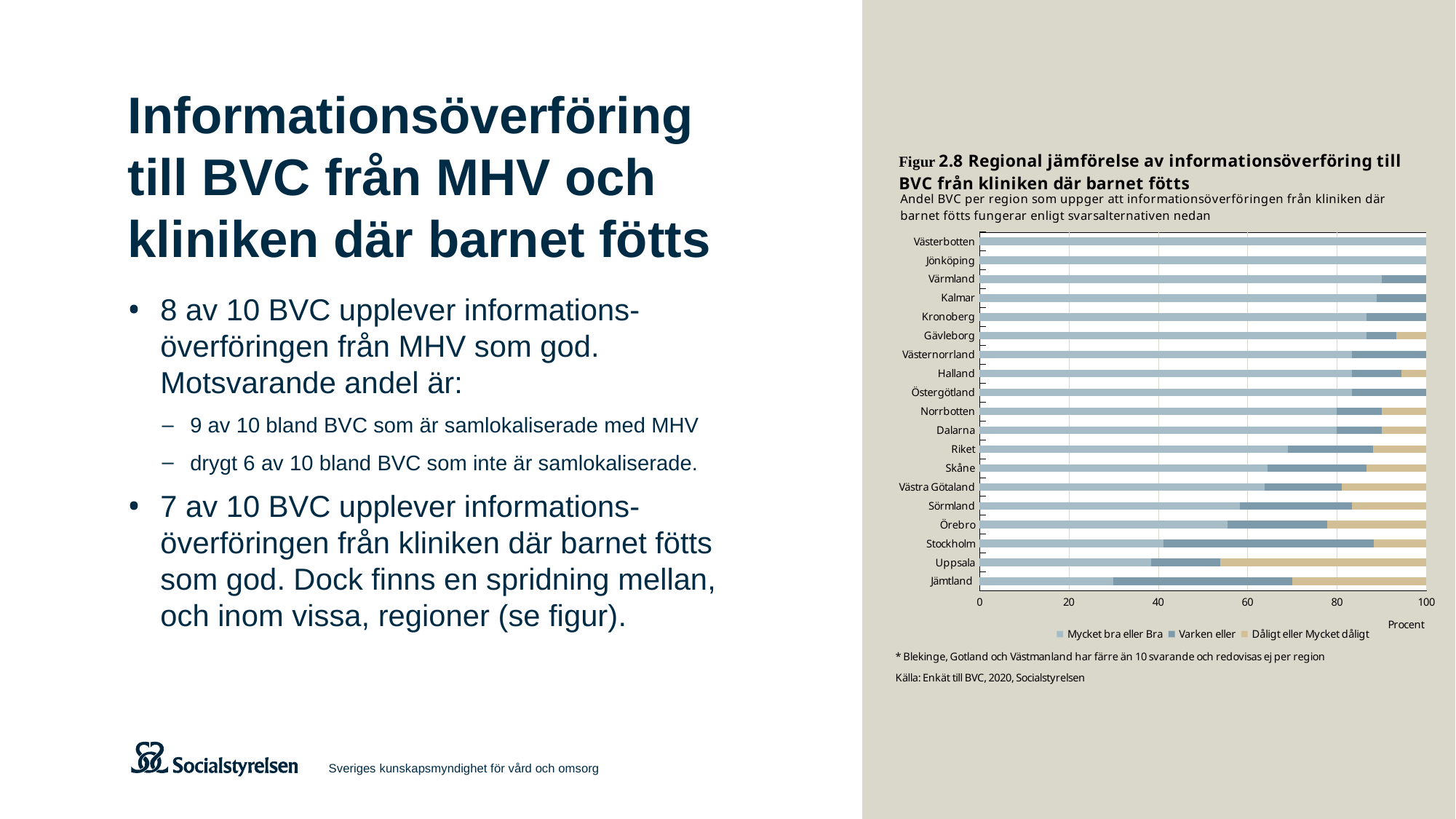
Is the 'Mycket bra eller Bra' value for Jämtland greater or less than 40? less How many regions (categories) are plotted on the chart? 19 Do the 'Mycket bra eller Bra' values rise or fall going down the list of regions from Västerbotten to Jämtland? fall Which region has the lowest share of 'Mycket bra eller Bra'? Jämtland Which has a larger 'Mycket bra eller Bra' share, Västerbotten or Jämtland? Västerbotten How many series does the chart legend list? 3 What unit is shown on the horizontal axis of the chart? Procent Is the 'Mycket bra eller Bra' value for Stockholm greater or less than 60? less What kind of chart is shown on the slide? Stacked bar chart Is the 'Mycket bra eller Bra' value for Riket greater or less than 60? greater Which has a larger 'Mycket bra eller Bra' share, Uppsala or Kalmar? Kalmar